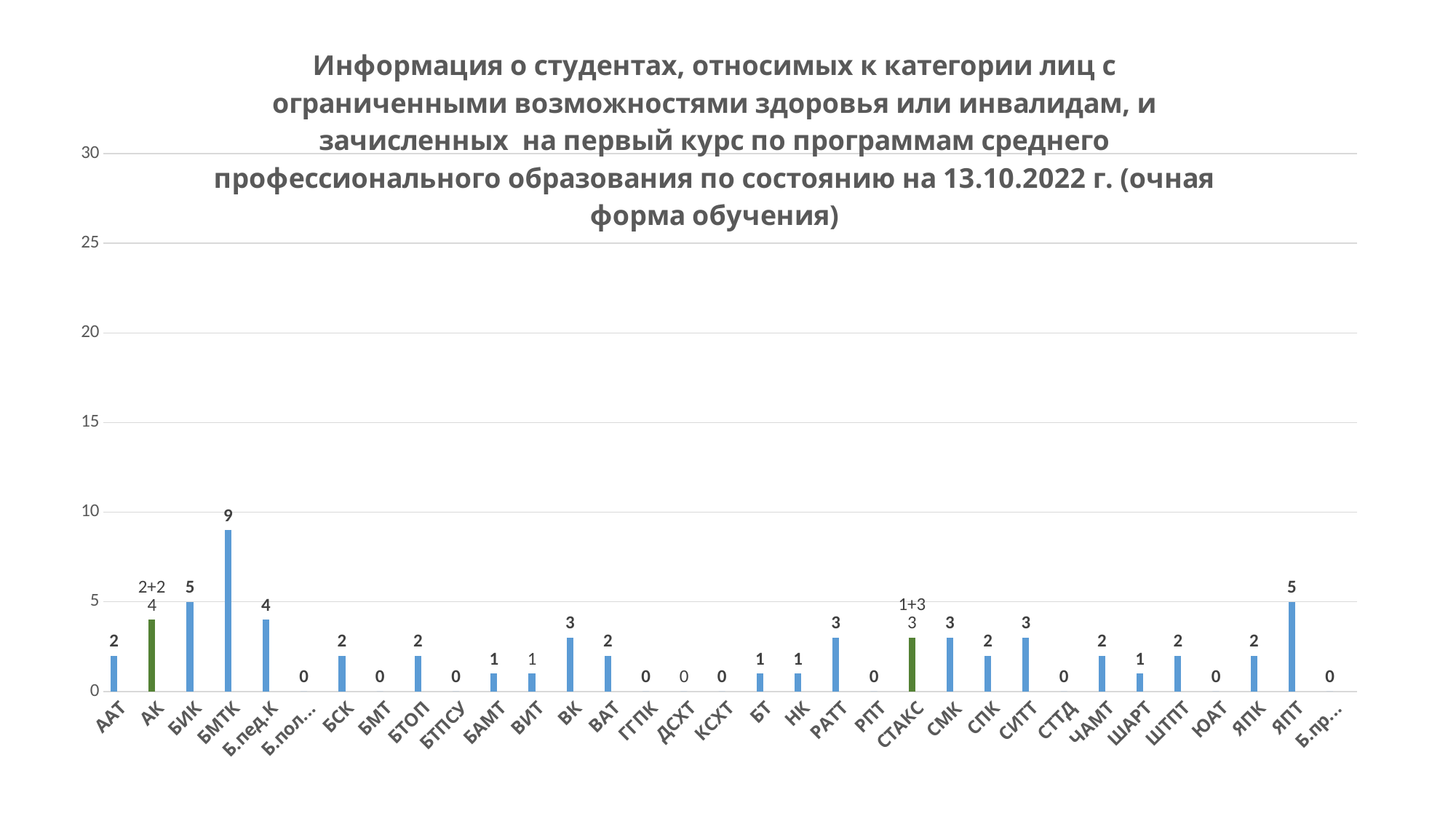
What kind of chart is this? bar chart Which is larger, the value for ВК or the value for ВАТ? ВК What is the value for РАТТ? 3 What is the value for ЯПТ? 5 What annotation is printed above the bar for СТАКС? 1+3 Is the value for БМТК greater or less than 5? greater What is the value for ШАРТ? 1 What is the value for БМТК? 9 Which two categories have green bars instead of blue? АК and СТАКС How many categories are shown on the x axis? 33 Which category has the highest value? БМТК What is the difference between the values for БМТК and БИК? 4